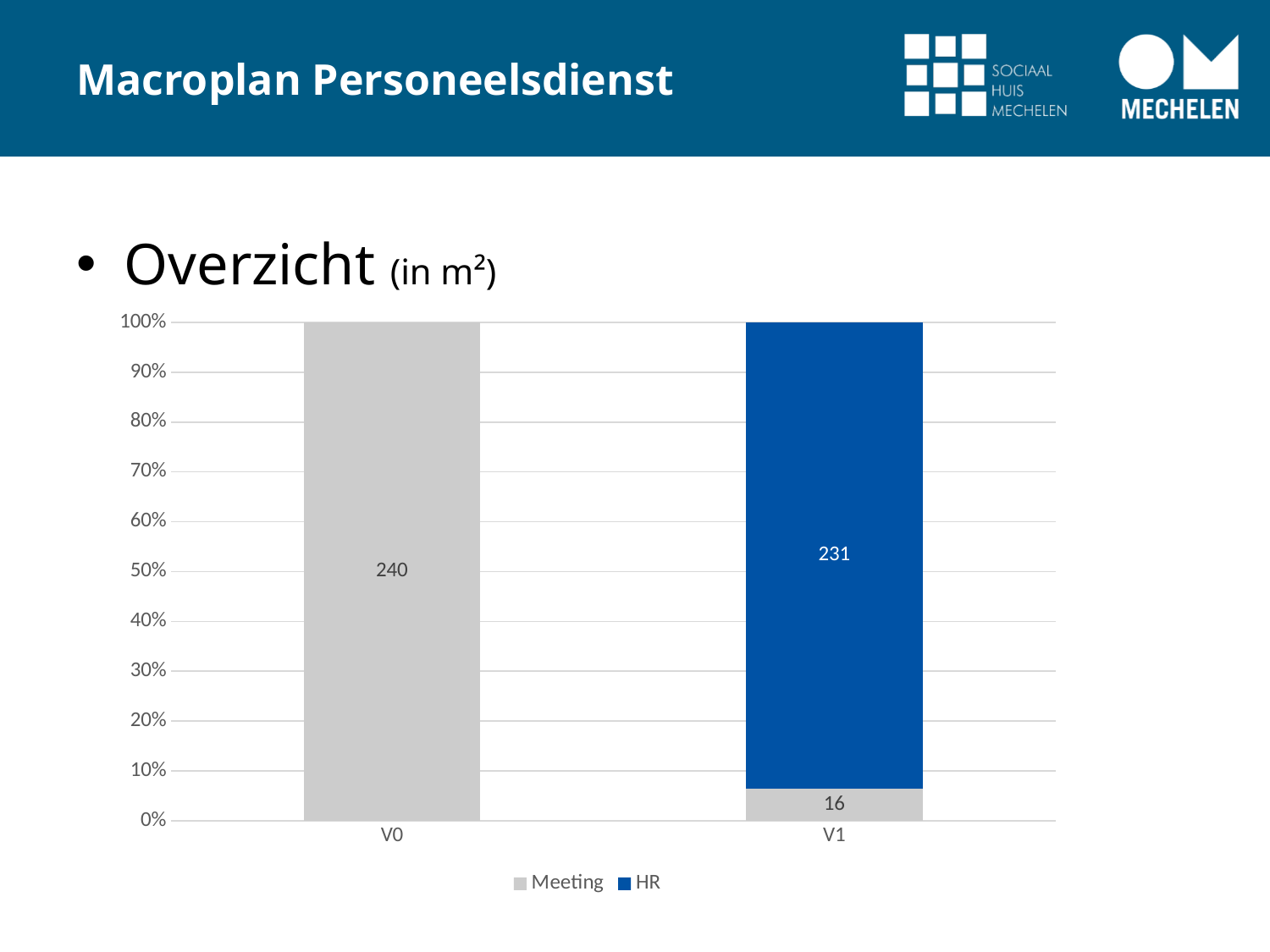
What is the difference between the Meeting value for V0 and the Meeting value for V1? 224 How many series does the legend list? 2 What is the value of the Meeting series for V1? 16 What kind of chart is shown on the slide? Stacked bar chart What is the difference between the HR value and the Meeting value for V1? 215 Which series is shown in blue in the legend? HR Which is larger for V1, the HR value or the Meeting value? HR What is the value of the HR series for V1? 231 Which category has the lower Meeting value, V0 or V1? V1 What is the total of the stacked bar for V1? 247 How many categories are shown on the x axis? 2 What is the value of the Meeting series for V0? 240